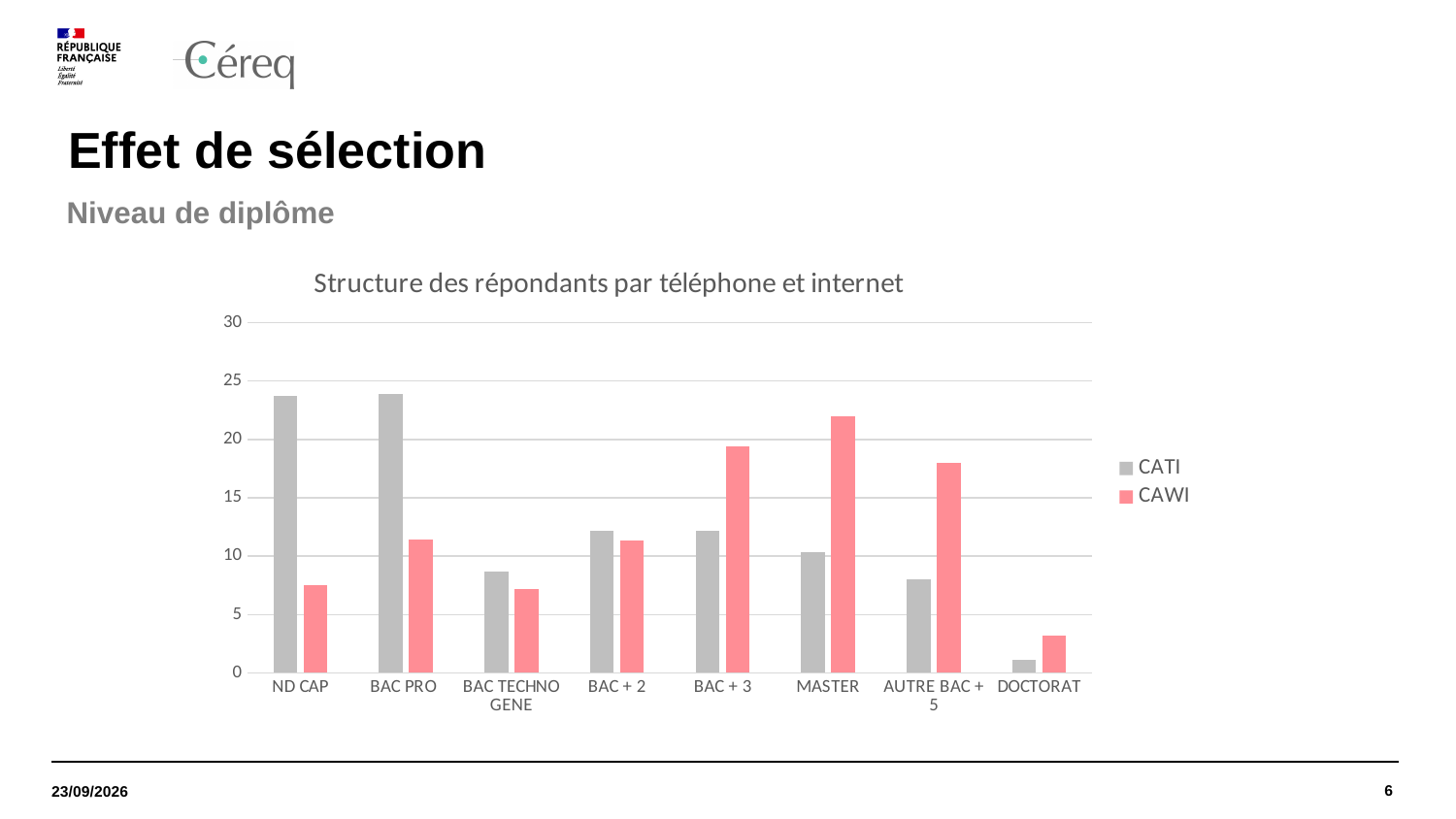
For ND CAP, which is larger, the CATI value or the CAWI value? CATI Is the CAWI value for MASTER greater or less than 20? greater What kind of chart is shown on the slide? bar chart Is the CAWI value for AUTRE BAC + 5 greater or less than 15? greater Is the CATI value for ND CAP greater or less than 20? greater What is the title of the chart? Structure des répondants par téléphone et internet Which category has the highest CAWI value? MASTER Which category has the lowest CAWI value? DOCTORAT How many diploma categories are shown on the x axis? 8 Which category has the lowest CATI value? DOCTORAT How many series does the legend list? 2